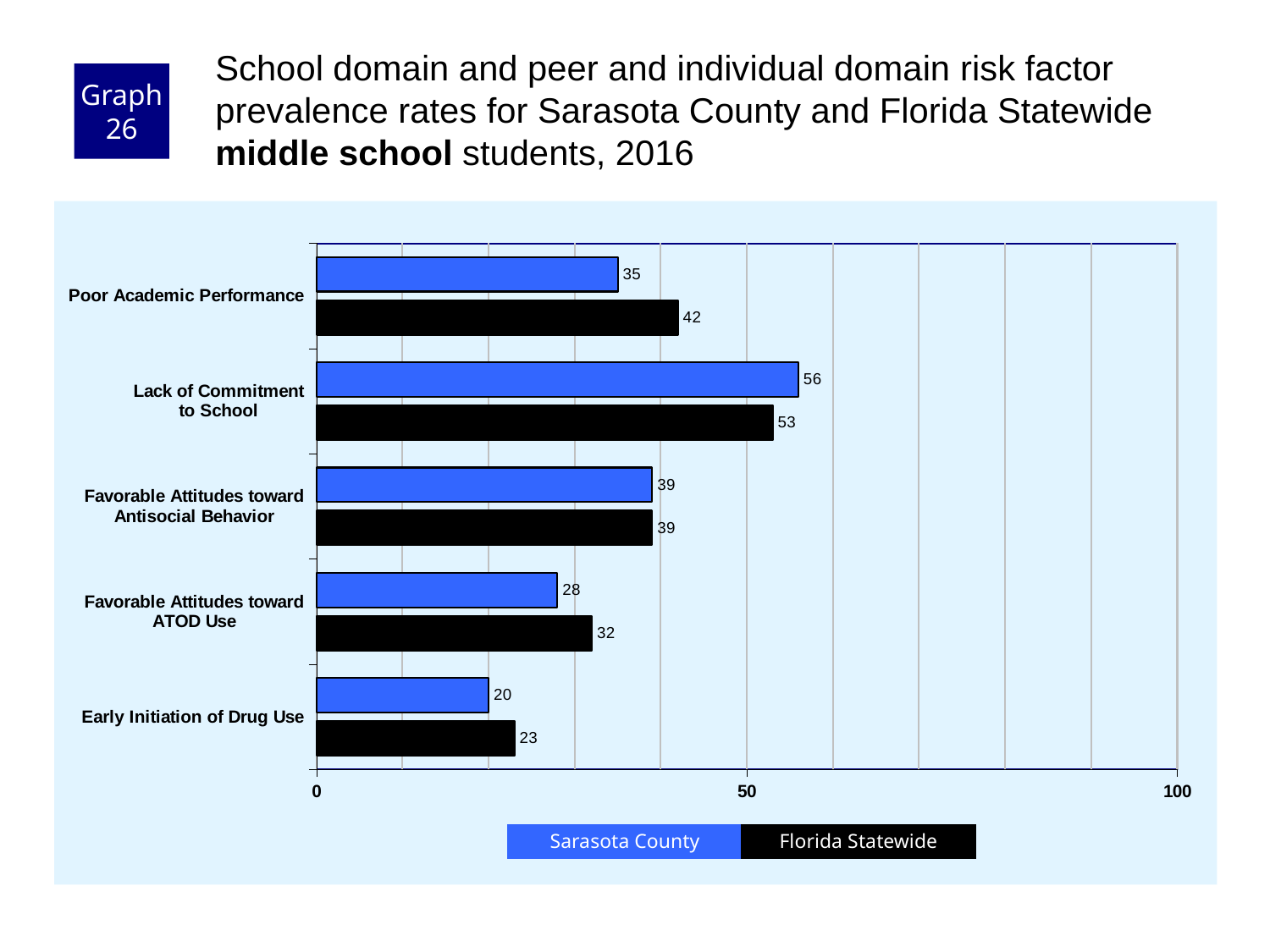
What kind of chart is shown on the slide? bar chart Which risk factor has the lowest Florida Statewide value? Early Initiation of Drug Use How many risk factor categories are shown on the chart? 5 How many series does the legend list? 2 Which risk factor has the highest Sarasota County value? Lack of Commitment to School Which colour represents Florida Statewide in the chart? black What is the Florida Statewide value for Favorable Attitudes toward ATOD Use? 32 Is the Sarasota County value for Lack of Commitment to School greater or less than 50? greater What is the Sarasota County value for Lack of Commitment to School? 56 For Lack of Commitment to School, which is larger: the Sarasota County value or the Florida Statewide value? Sarasota County What is the difference between the Florida Statewide and Sarasota County values for Poor Academic Performance? 7 What is the Florida Statewide value for Early Initiation of Drug Use? 23